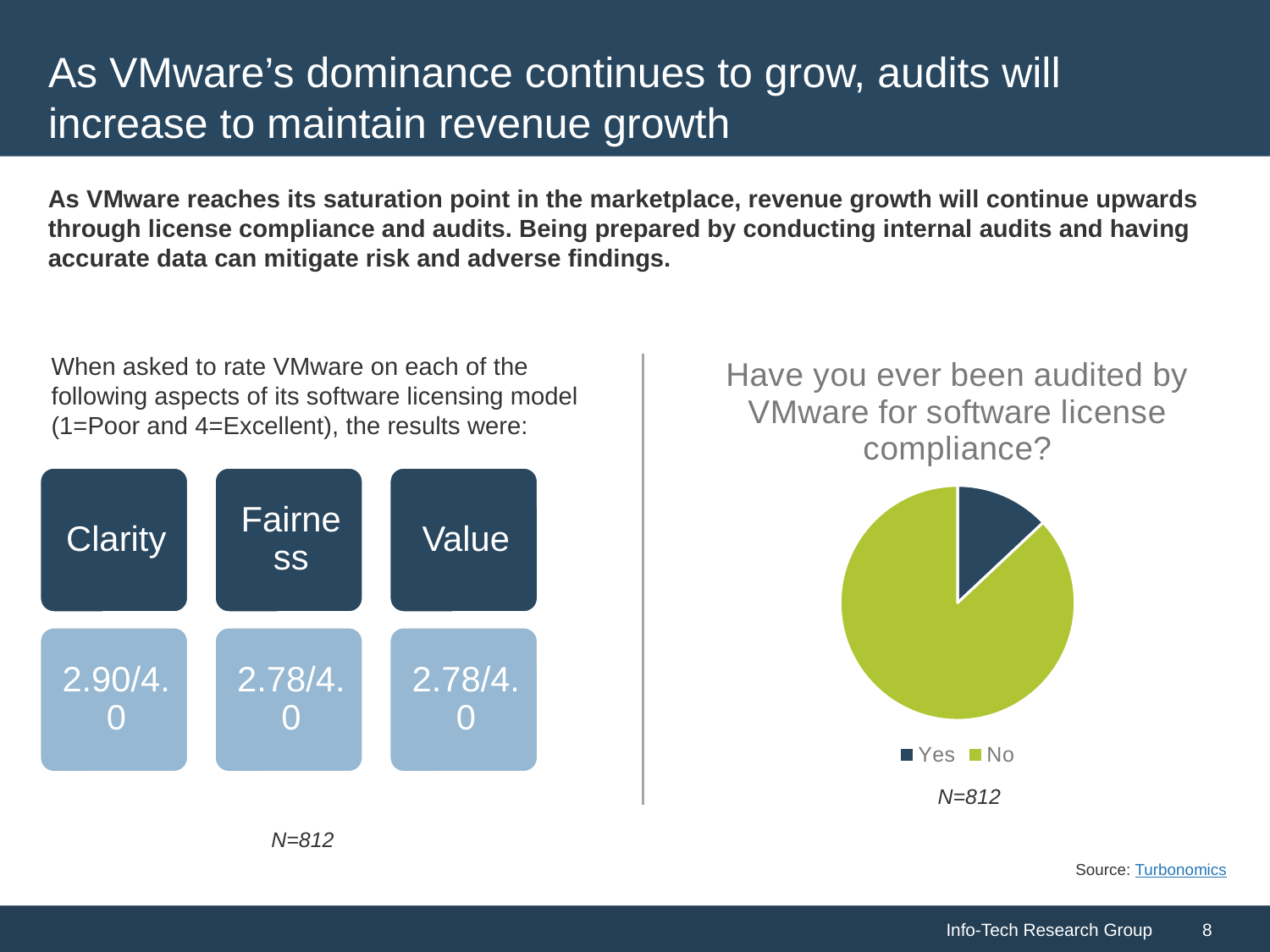
In the pie chart about being audited by VMware, does the Yes slice represent more or less than half of the pie? less What kind of chart is shown on the right side of the slide under the question about being audited by VMware? pie chart In the pie chart about being audited by VMware, how many slices does the pie have? 2 In the pie chart about being audited by VMware, which slice is larger, Yes or No? No What question is the pie chart on the right side of the slide titled with? Have you ever been audited by VMware for software license compliance? In the pie chart about being audited by VMware, how many entries does the legend list? 2 What sample size (N) is shown beneath the pie chart about being audited by VMware? N=812 In the pie chart about being audited by VMware, which response has the largest slice? No In the pie chart about being audited by VMware, which response has the smallest slice? Yes In the pie chart about being audited by VMware, what colour is the No slice? green